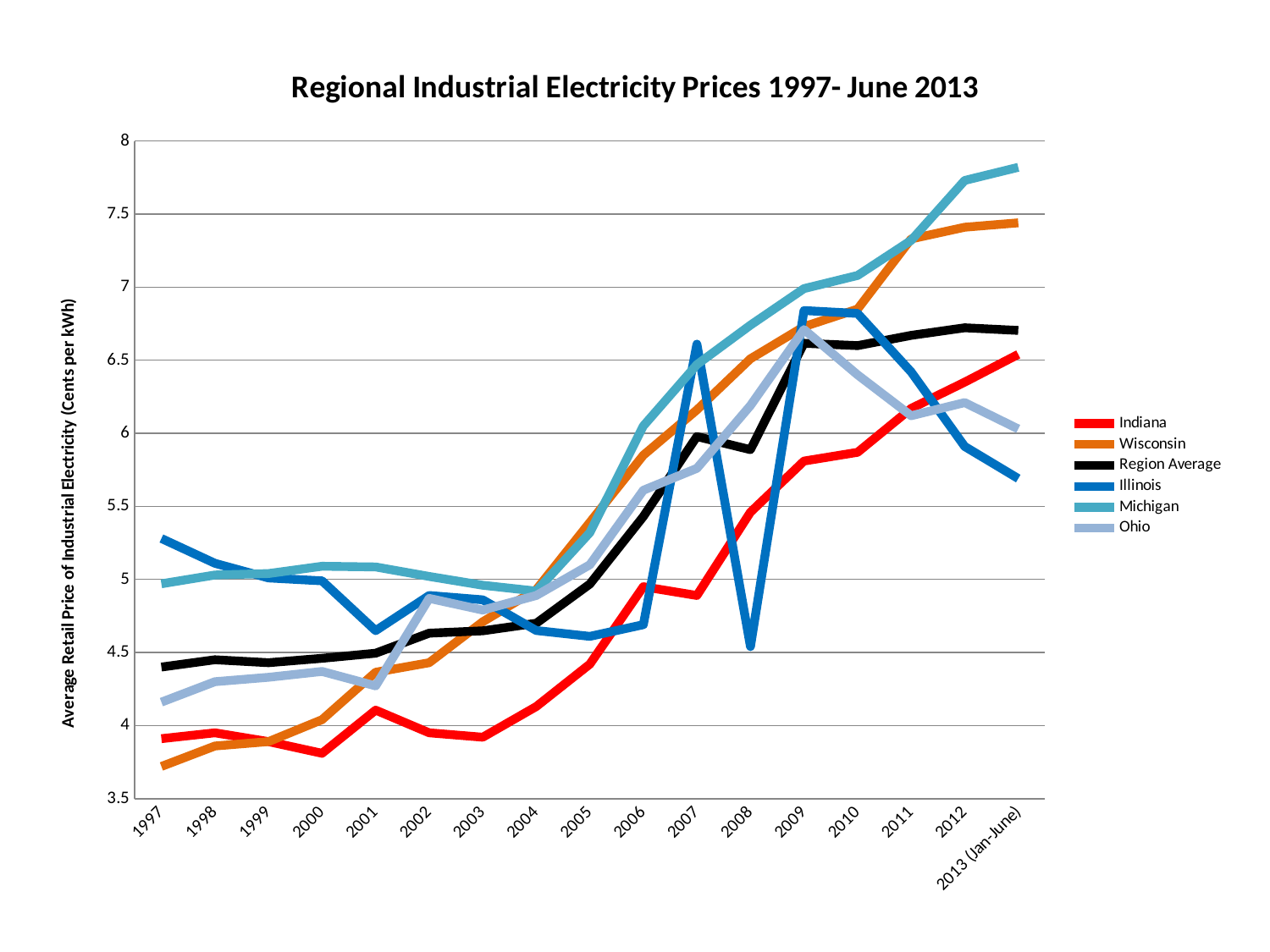
Which series has the lowest value in 2013 (Jan-June)? Illinois Is the value for Indiana in 2000 greater or less than 4? less Does the Illinois line rise or fall from 2010 to 2013 (Jan-June)? fall In 2009, which is higher: Wisconsin or Indiana? Wisconsin What kind of chart is shown on the slide? line chart How many series does the legend list? 6 How many time points are shown along the x axis? 17 Which series has the highest value in 2013 (Jan-June)? Michigan Is the value for Illinois in 2008 greater or less than 5? less Is the value for Michigan in 2012 greater or less than 7.5? greater Which series has the lowest value in 1997? Wisconsin